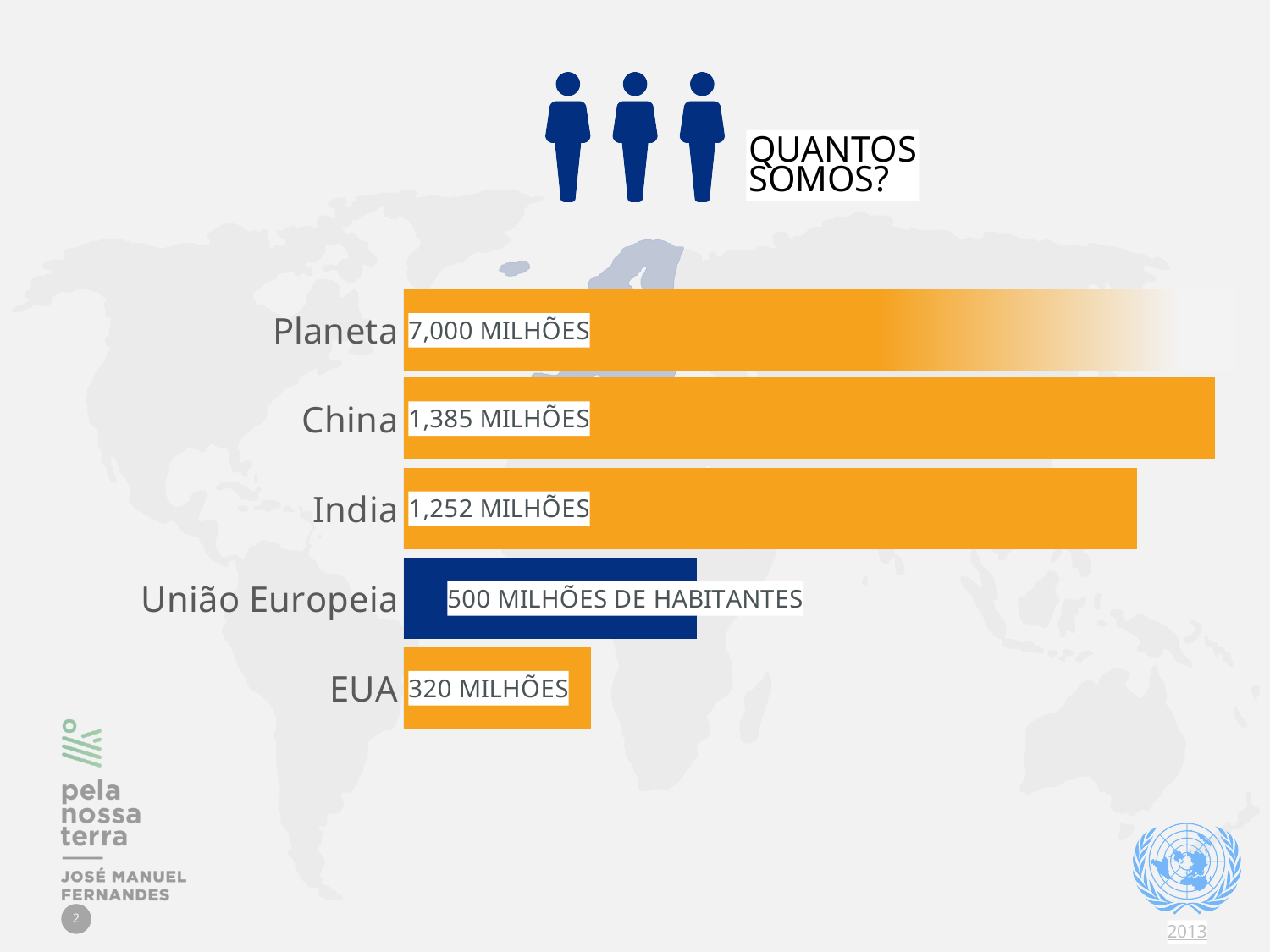
What is the value shown for India? 1,252 MILHÕES What is the value shown for China? 1,385 MILHÕES What is the value shown for União Europeia? 500 MILHÕES DE HABITANTES What type of chart is shown on the slide? bar chart Which category has the highest value? Planeta What is the difference in milhões between União Europeia and EUA? 180 milhões Which is larger, the value for China or the value for India? China What is the value shown for EUA? 320 MILHÕES What is the difference in milhões between China and India? 133 milhões Which category has the lowest value? EUA How many categories are shown in the chart? 5 What is the value shown for Planeta? 7,000 MILHÕES